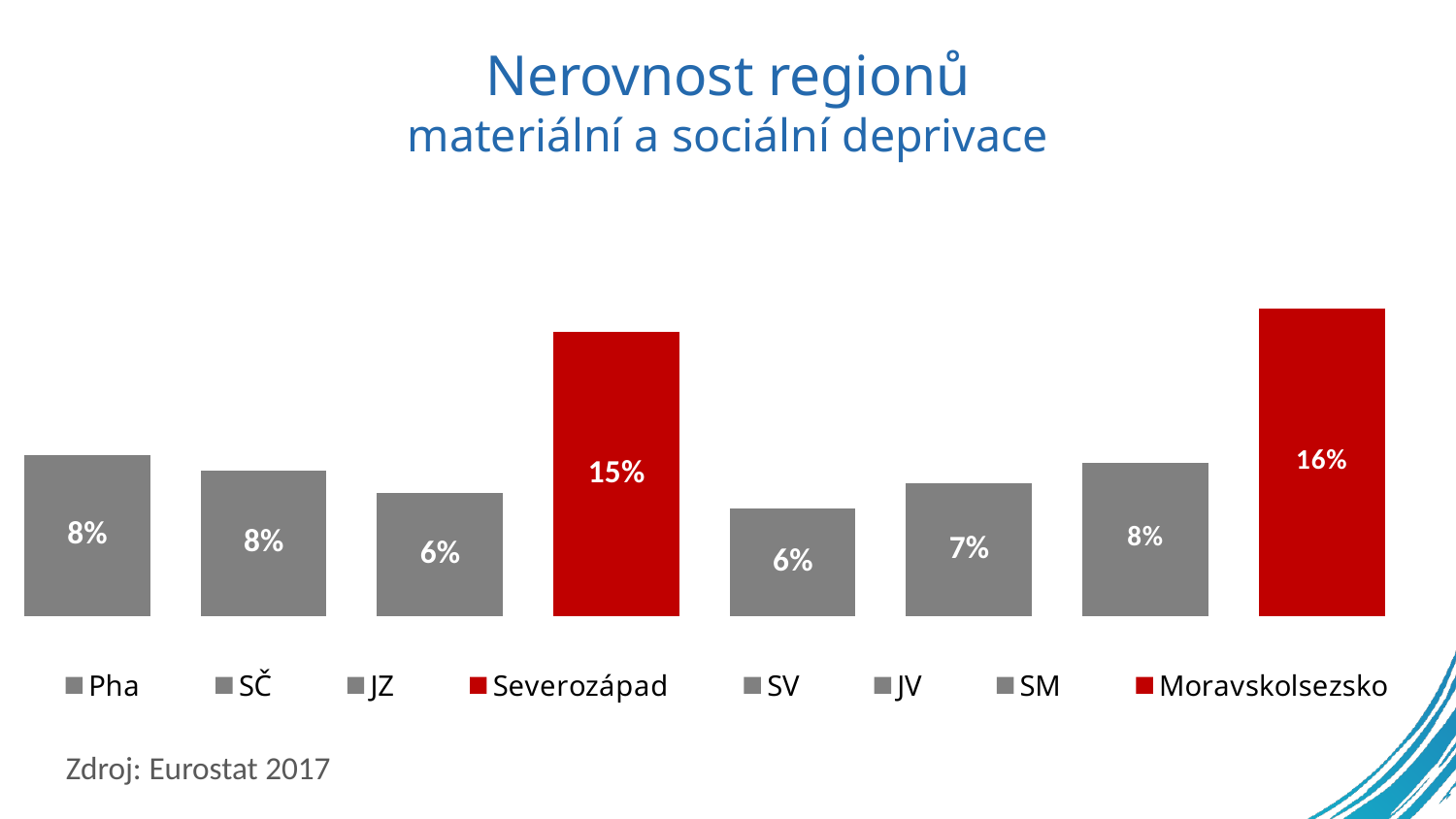
Which is larger, the value for Severozápad or the value for SM? Severozápad What kind of chart is shown on the slide? Bar chart What is the difference between the values for Moravskoslezsko and Severozápad? 1 percentage point What is the value shown for Severozápad? 15% Which region has the highest value in the chart? Moravskolsezsko What is the value shown for Pha? 8% How many entries does the legend list? 8 What is the value shown for Moravskoslezsko? 16% What is the difference between the values for Severozápad and Pha? 7 percentage points What is the value shown for JZ? 6% What is the value shown for JV? 7% How many bars are plotted in the chart? 8